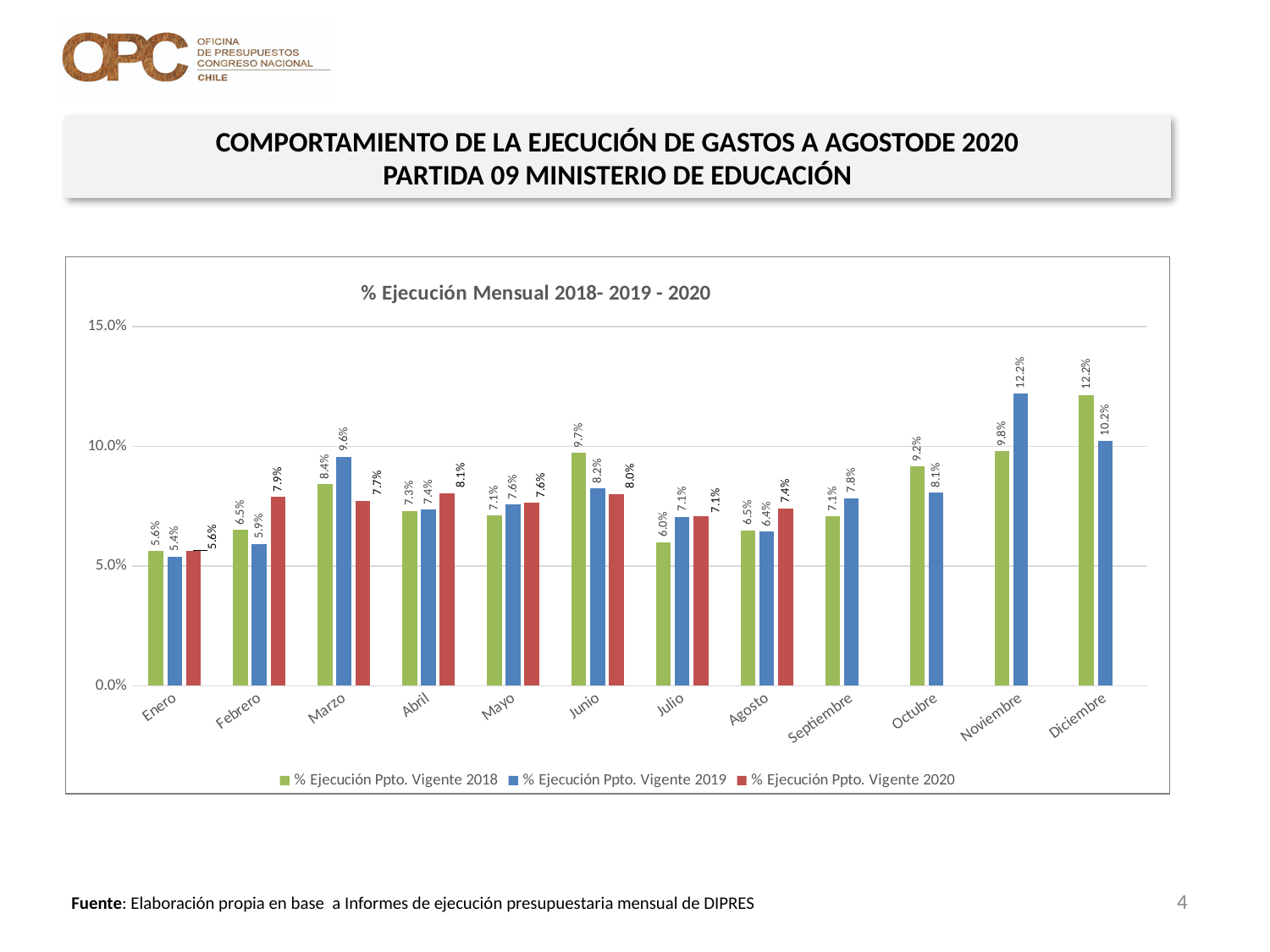
What is the difference between the 2019 and 2018 values in Noviembre? 2.4% Which is larger in Marzo: the 2018 value or the 2020 value? 2018 value (8.4%) What kind of chart is shown on the slide? Bar chart What is the value for % Ejecución Ppto. Vigente 2018 in Junio? 9.7% How many months are shown on the x axis? 12 Is the value for % Ejecución Ppto. Vigente 2019 in Noviembre greater or less than 10.0%? greater What is the title of the chart? % Ejecución Mensual 2018- 2019 - 2020 Which month has the highest value for % Ejecución Ppto. Vigente 2018? Diciembre How many series does the legend list? 3 What is the value for % Ejecución Ppto. Vigente 2020 in Febrero? 7.9% What is the value for % Ejecución Ppto. Vigente 2019 in Marzo? 9.6% Which month has the lowest value for % Ejecución Ppto. Vigente 2019? Enero